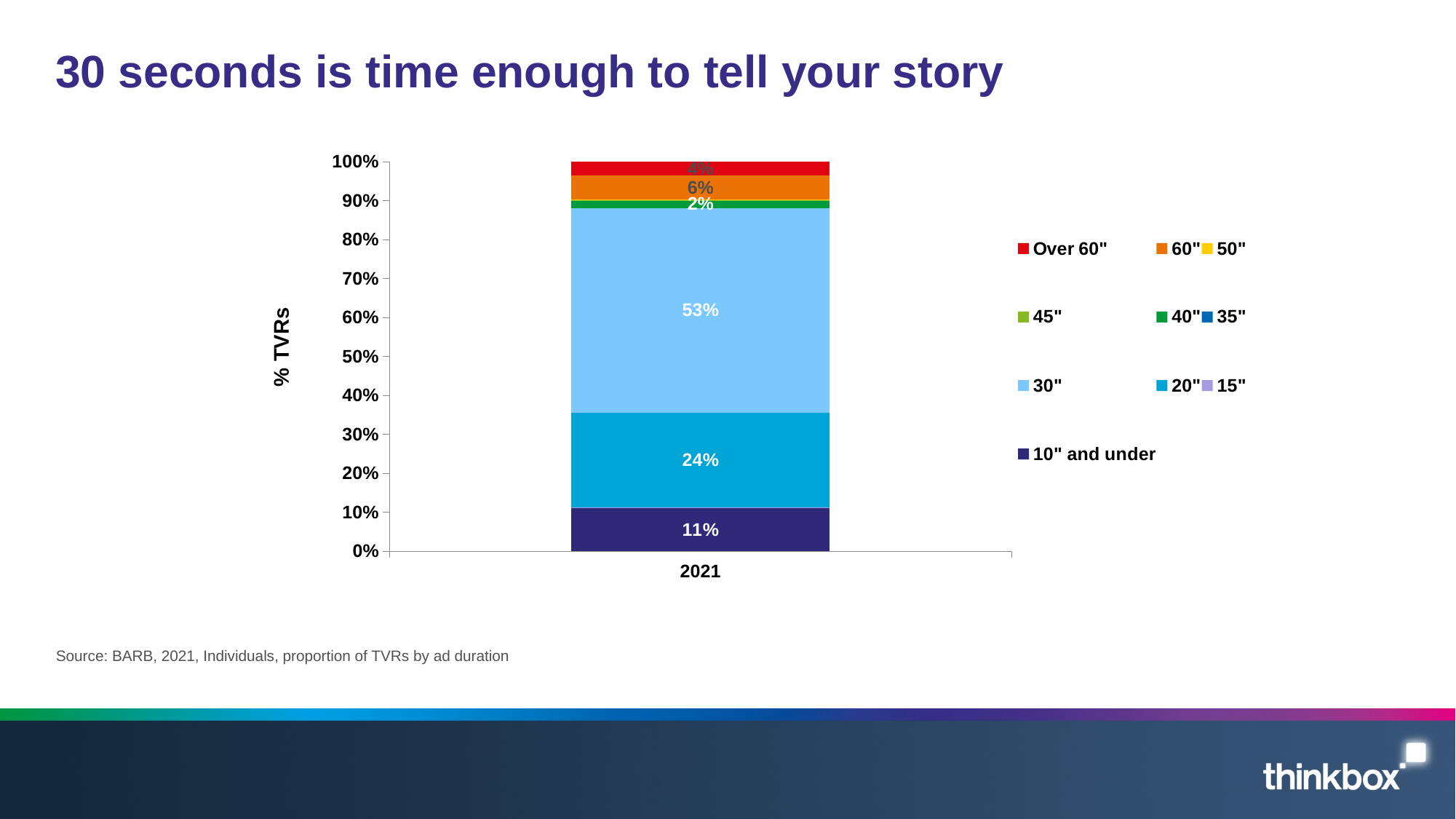
How many series does the legend list? 10 Which is larger in 2021, the 20" segment or the 10" and under segment? 20" What is the value for the 30" segment in 2021? 53% What is the title of the y axis? % TVRs What is the value for the 60" segment in 2021? 6% What is the value for the 20" segment in 2021? 24% What is the difference between the 30" and 20" segments in 2021? 29% What is the value for the 10" and under segment in 2021? 11% Is the value for the 30" segment greater or less than 50%? greater What kind of chart is shown on the slide? Stacked bar chart How many categories are shown on the x axis? 1 Which ad duration has the largest share of TVRs in 2021? 30"